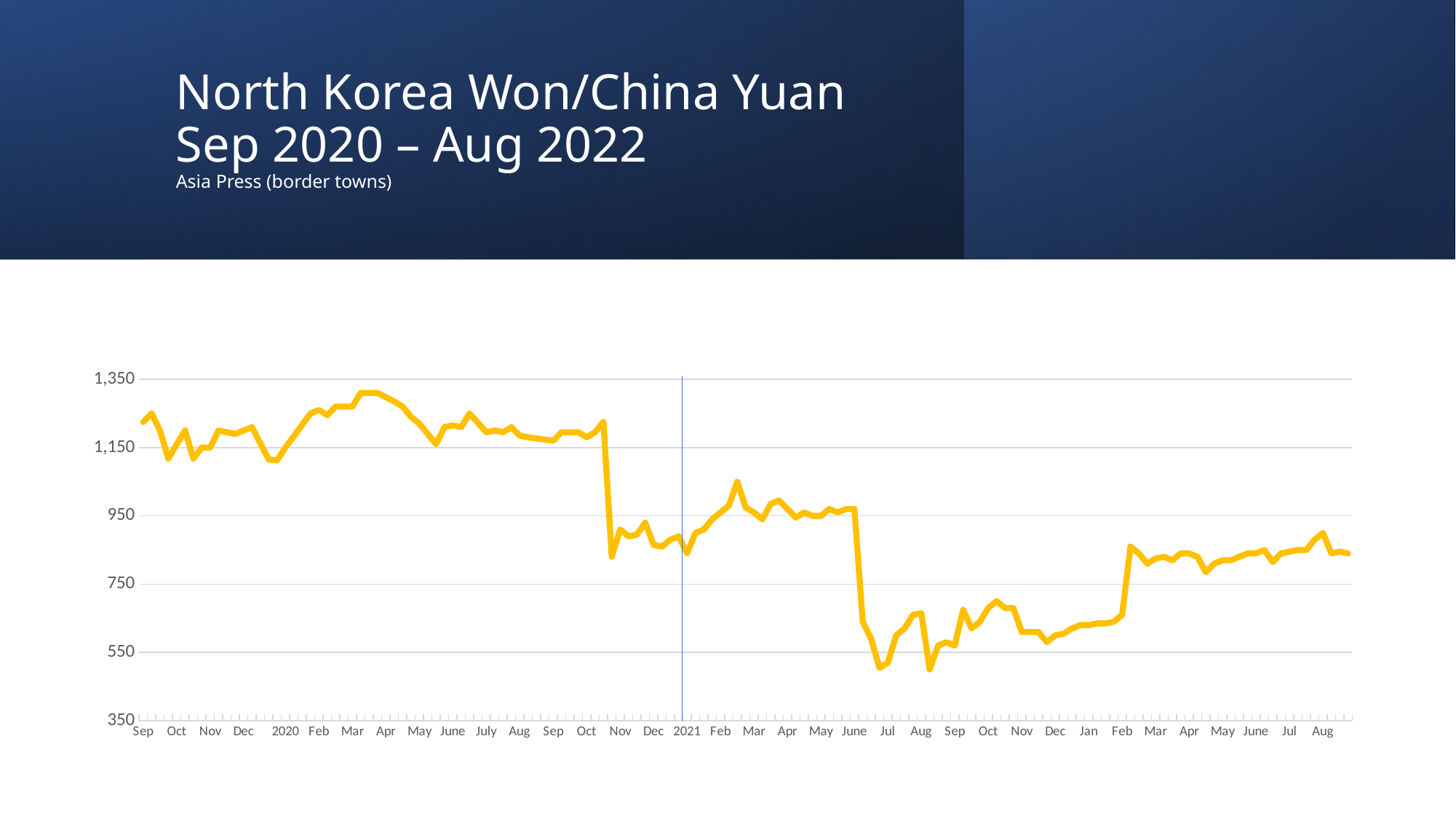
Is the value for Aug 2022 greater or less than 950? less What is the title of the chart on the slide? North Korea Won/China Yuan Sep 2020 – Aug 2022 Is the value for Dec 2021 greater or less than 750? less Overall, does the line rise or fall from Sep 2020 to Aug 2022? fall Which is higher, the value for Apr 2021 or the value for Jul 2021? Apr 2021 What source is cited under the chart title? Asia Press (border towns) Which is higher, the value for Sep 2020 or the value for Aug 2022? Sep 2020 What kind of chart is shown on the slide? line chart Is the value for Sep 2020 greater or less than 1,150? greater